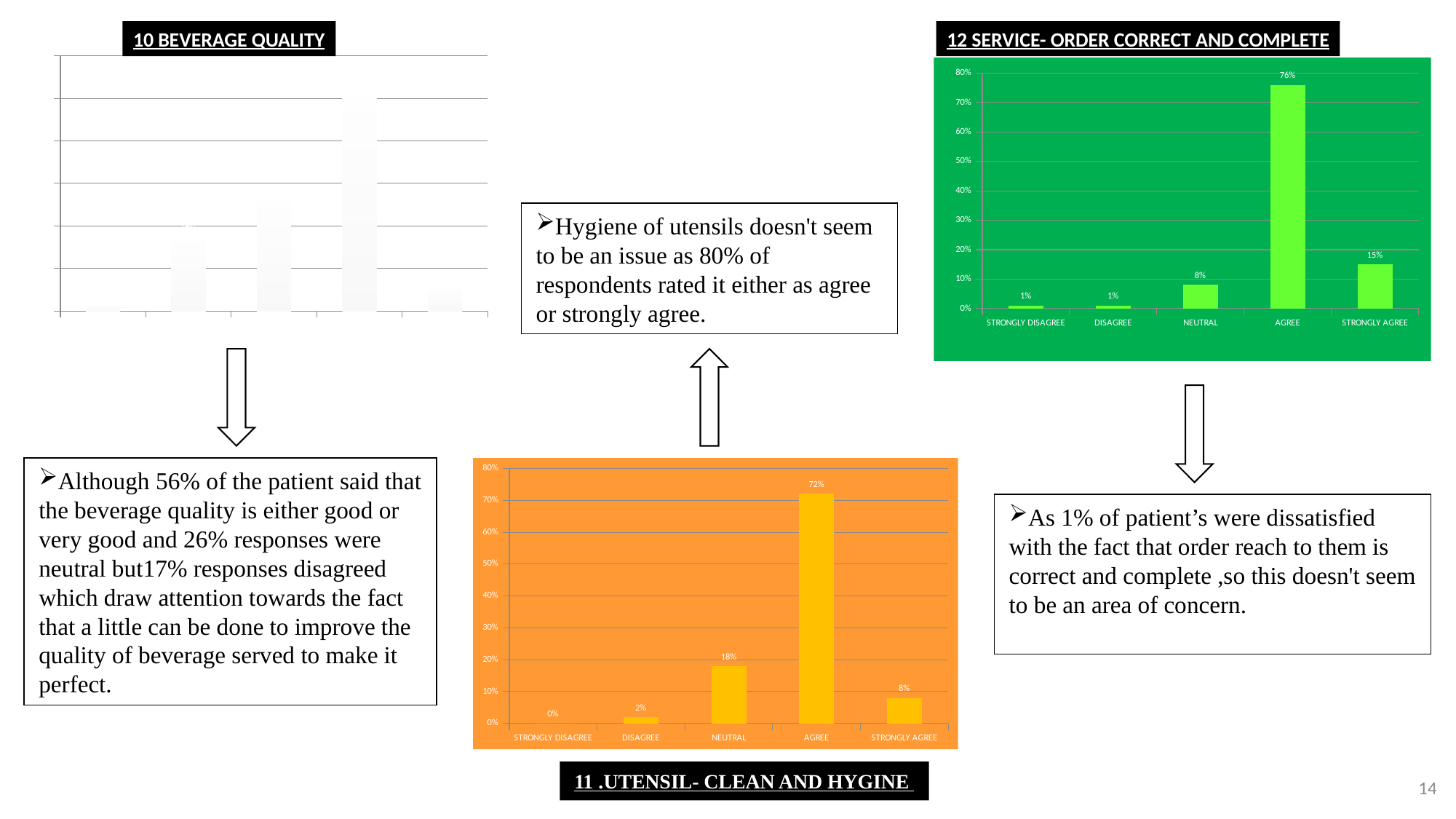
In the '11 .UTENSIL- CLEAN AND HYGINE' chart, what is the difference between the values for AGREE and NEUTRAL? 54% In the '12 SERVICE- ORDER CORRECT AND COMPLETE' chart, what is the value for STRONGLY AGREE? 15% In the '12 SERVICE- ORDER CORRECT AND COMPLETE' chart, what is the value for AGREE? 76% What is the background colour of the '12 SERVICE- ORDER CORRECT AND COMPLETE' chart? Green In the '12 SERVICE- ORDER CORRECT AND COMPLETE' chart, which category has the highest value? AGREE In the '11 .UTENSIL- CLEAN AND HYGINE' chart, which is larger, the value for NEUTRAL or the value for STRONGLY AGREE? NEUTRAL In the '11 .UTENSIL- CLEAN AND HYGINE' chart, which category has the lowest value? STRONGLY DISAGREE In the '12 SERVICE- ORDER CORRECT AND COMPLETE' chart, what is the difference between the values for AGREE and STRONGLY AGREE? 61% In the '11 .UTENSIL- CLEAN AND HYGINE' chart, what is the value for STRONGLY DISAGREE? 0% In the '11 .UTENSIL- CLEAN AND HYGINE' chart, what is the value for NEUTRAL? 18% In the '12 SERVICE- ORDER CORRECT AND COMPLETE' chart, how many categories are shown on the x axis? 5 What kind of chart is the '11 .UTENSIL- CLEAN AND HYGINE' chart? Bar chart